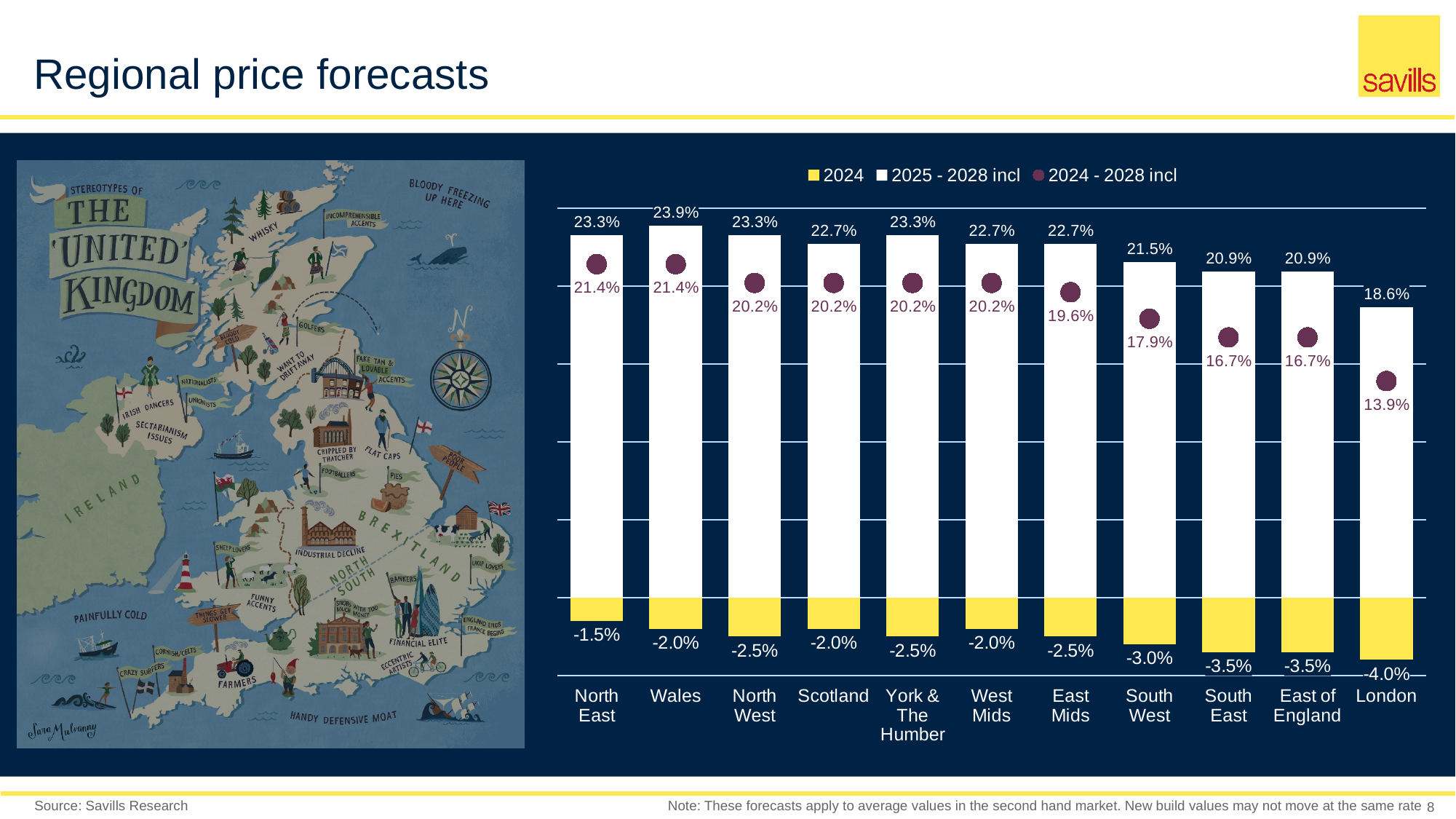
What kind of chart is used to show the 2024 and 2025 - 2028 incl series? Bar chart What is the 2025 - 2028 incl value for Wales? 23.9% What is the 2024 value for London? -4.0% How many series does the legend list? 3 Which region has the lowest 2024 - 2028 incl value? London Do the 2024 - 2028 incl values generally rise or fall from North East to London along the x axis? Fall What is the 2024 - 2028 incl value for South West? 17.9% Which region has the highest 2025 - 2028 incl value? Wales How many regions are shown on the x axis? 11 Which is larger, the 2025 - 2028 incl value for Scotland or for South East? Scotland What is the difference between the 2024 - 2028 incl values for North East and London? 7.5% Which series is shown with circular markers rather than bars? 2024 - 2028 incl